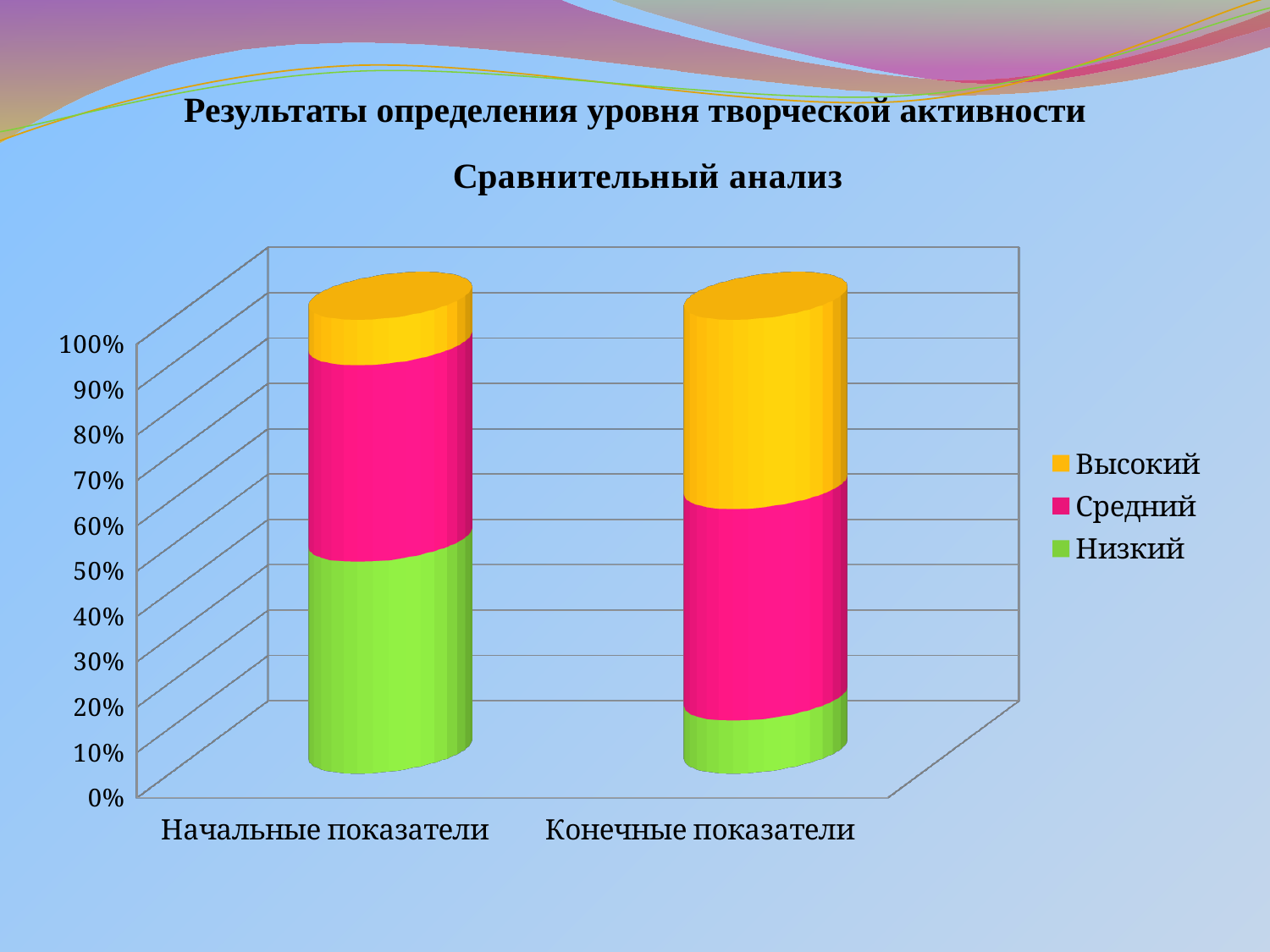
Which category has the larger Низкий value, Начальные показатели or Конечные показатели? Начальные показатели Which series are listed in the chart legend? Высокий, Средний, Низкий Which series has the smallest segment in the Начальные показатели bar? Высокий How many series does the chart legend list? 3 Is the Высокий value for Конечные показатели greater or less than 20%? greater Is the Высокий value for Начальные показатели greater or less than 30%? less Is the Низкий value for Начальные показатели greater or less than 30%? greater How many categories are shown on the x axis of the chart? 2 Which category has the larger Высокий value, Начальные показатели or Конечные показатели? Конечные показатели What kind of chart is shown on the slide? Stacked bar chart What are the two category labels on the x axis? Начальные показатели, Конечные показатели